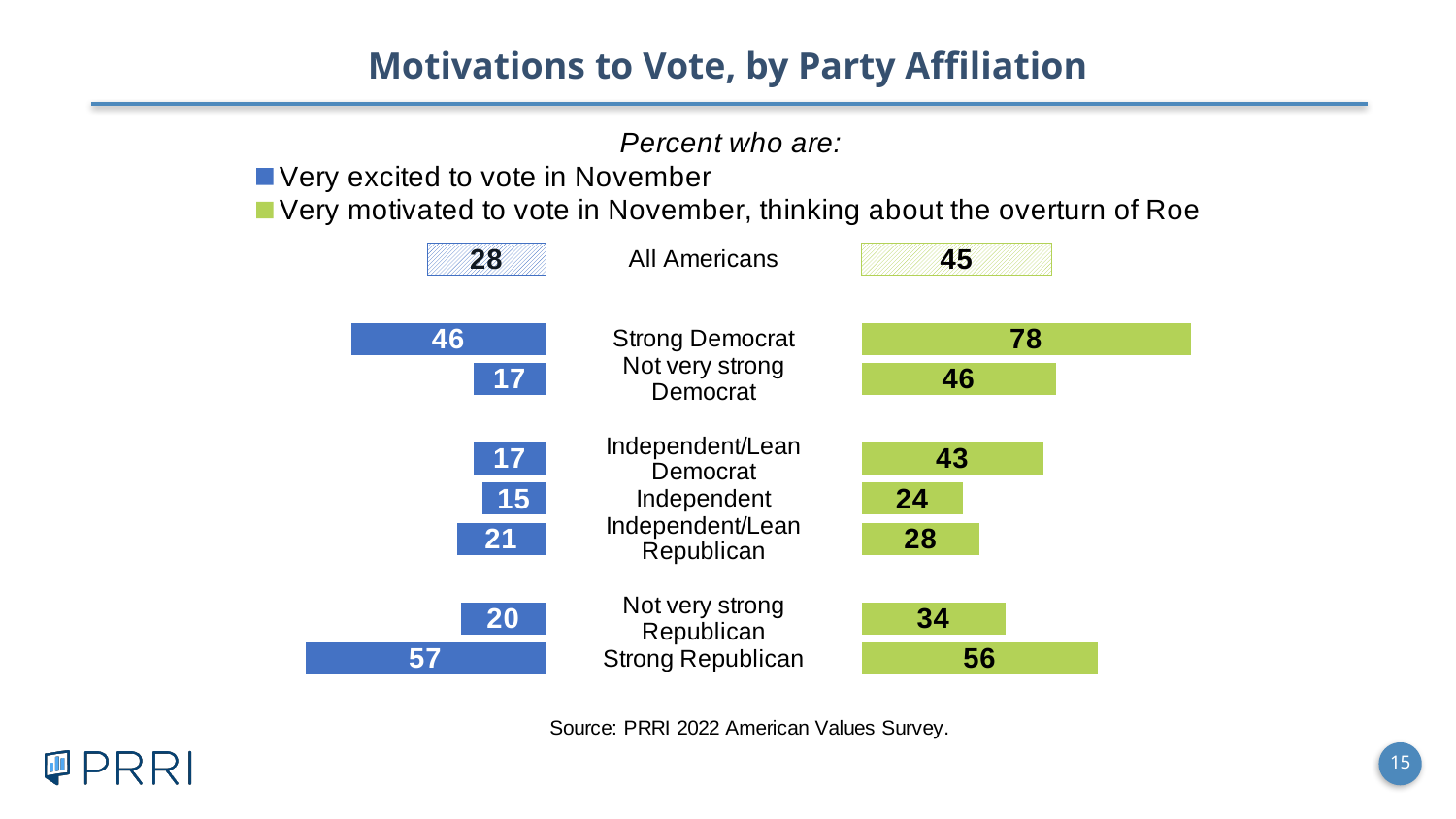
What percent of Independents are very motivated to vote in November, thinking about the overturn of Roe? 24 Which party affiliation group has the highest percent very motivated to vote in November, thinking about the overturn of Roe? Strong Democrat What kind of chart is shown on the slide? Bar chart What percent of Strong Democrats are very excited to vote in November? 46 How many party affiliation groups (including All Americans) are shown in the chart? 8 What percent of All Americans are very motivated to vote in November, thinking about the overturn of Roe? 45 What is the title of the chart on the slide? Percent who are: Which party affiliation group has the lowest percent very excited to vote in November? Independent Which party affiliation group has the highest percent very excited to vote in November? Strong Republican What is the difference between the percent of Strong Democrats and Strong Republicans who are very motivated to vote in November, thinking about the overturn of Roe? 22 How many series does the legend list? 2 Which is larger: the percent of Strong Republicans very excited to vote in November, or the percent of Strong Republicans very motivated to vote thinking about the overturn of Roe? Very excited to vote in November (57)